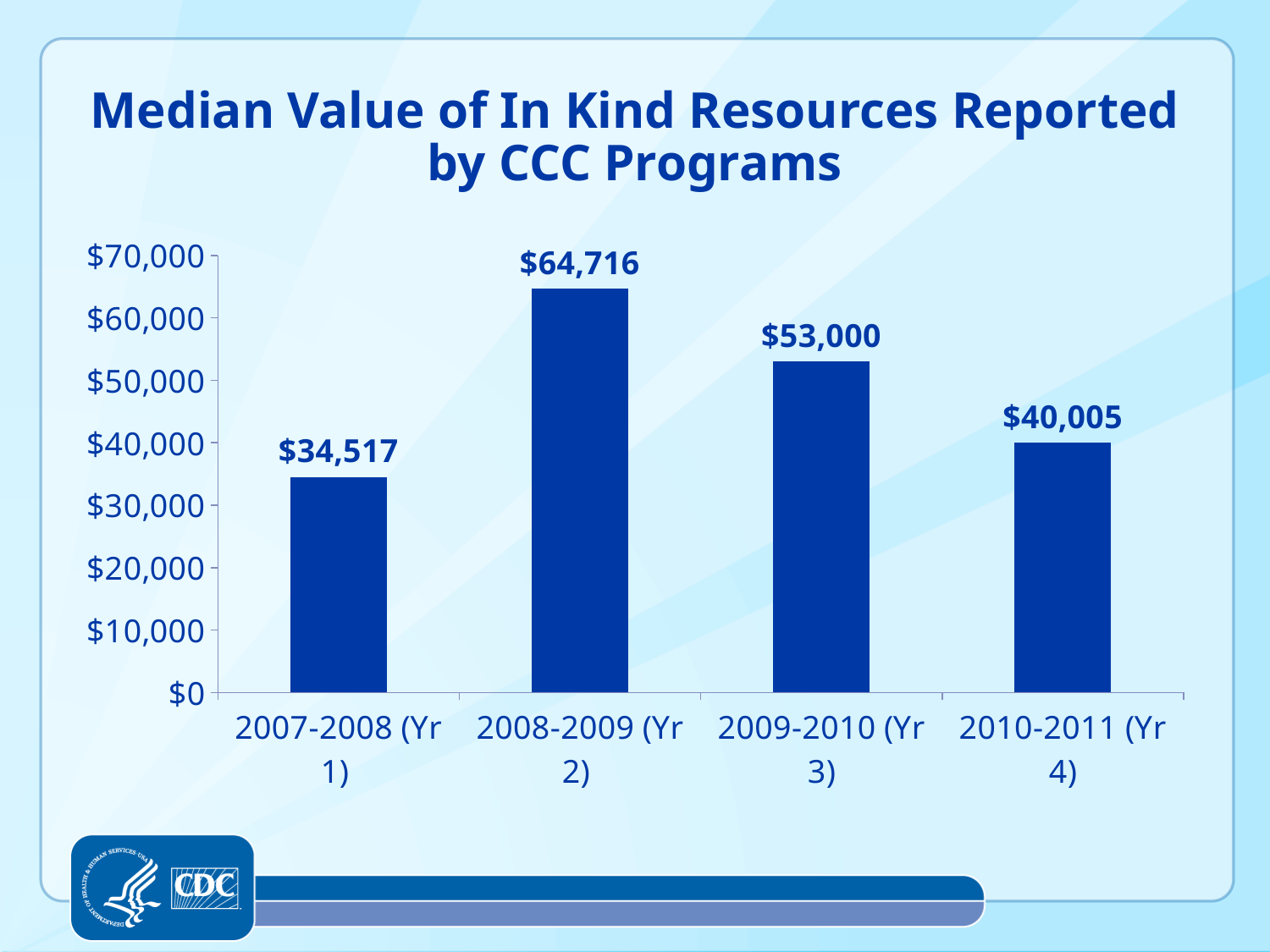
What is the difference between the median values for 2008-2009 (Yr 2) and 2009-2010 (Yr 3)? $11,716 What is the title of the chart? Median Value of In Kind Resources Reported by CCC Programs How many years are shown on the chart? 4 What kind of chart is shown on the slide? Bar chart What is the median value of in kind resources for 2008-2009 (Yr 2)? $64,716 Which is larger, the median value for 2010-2011 (Yr 4) or for 2007-2008 (Yr 1)? 2010-2011 (Yr 4) Which year has the highest median value of in kind resources? 2008-2009 (Yr 2) What is the median value of in kind resources for 2010-2011 (Yr 4)? $40,005 What is the median value of in kind resources for 2007-2008 (Yr 1)? $34,517 Which year has the lowest median value of in kind resources? 2007-2008 (Yr 1) Is the median value for 2009-2010 (Yr 3) greater or less than $50,000? greater What is the median value of in kind resources for 2009-2010 (Yr 3)? $53,000